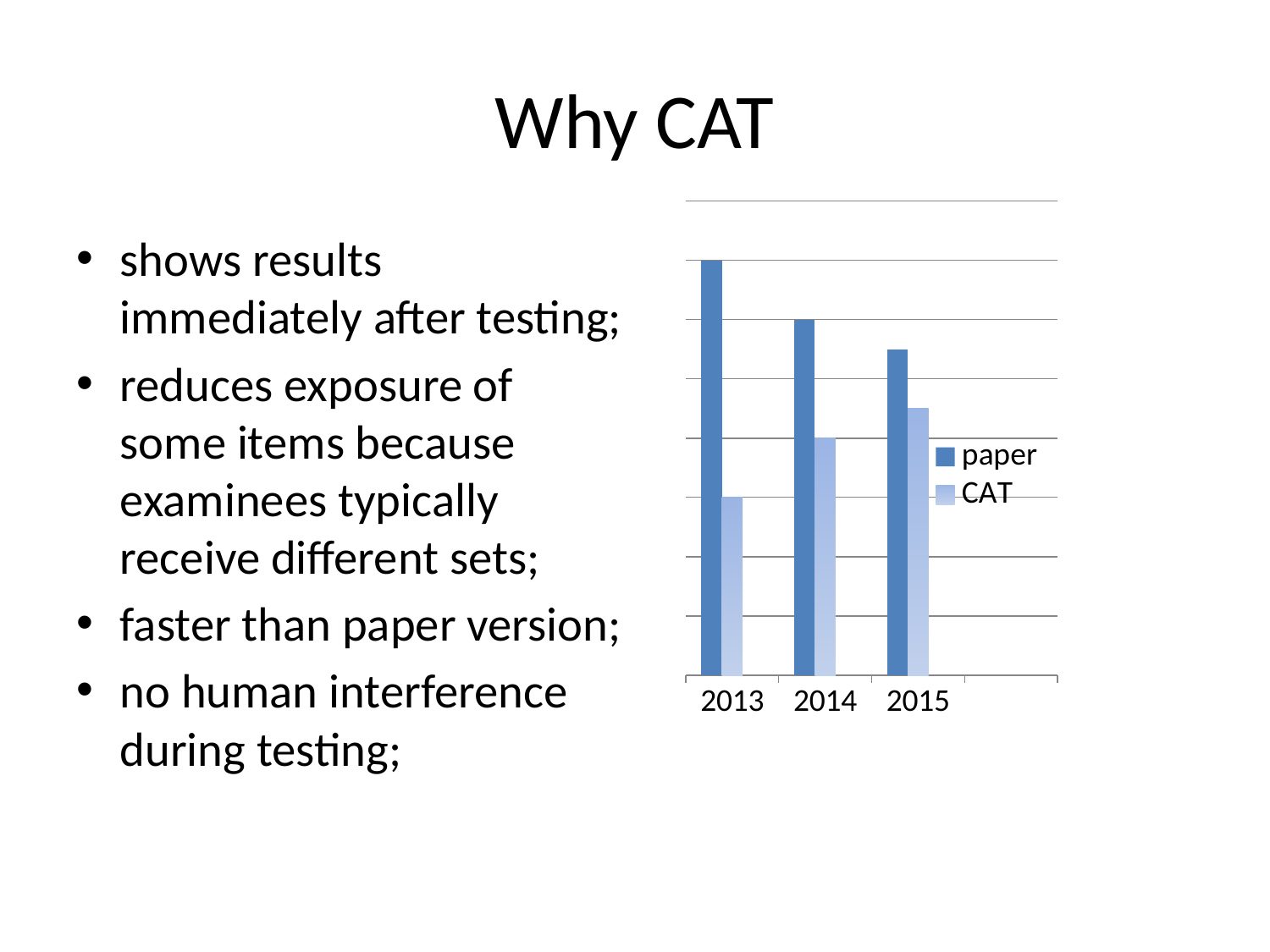
How many series does the chart's legend list? 2 In 2015, which series has the larger value, paper or CAT? paper What kind of chart is shown on the slide? bar chart In which year is the paper series lowest? 2015 Do the values for the paper series rise or fall from 2013 to 2015? fall In which year is the paper series highest? 2013 In which year is the CAT series lowest? 2013 How many categories are shown on the x axis of the chart? 3 Do the values for the CAT series rise or fall from 2013 to 2015? rise What are the two series named in the chart's legend? paper and CAT In 2013, which series has the larger value, paper or CAT? paper In which year is the CAT series highest? 2015